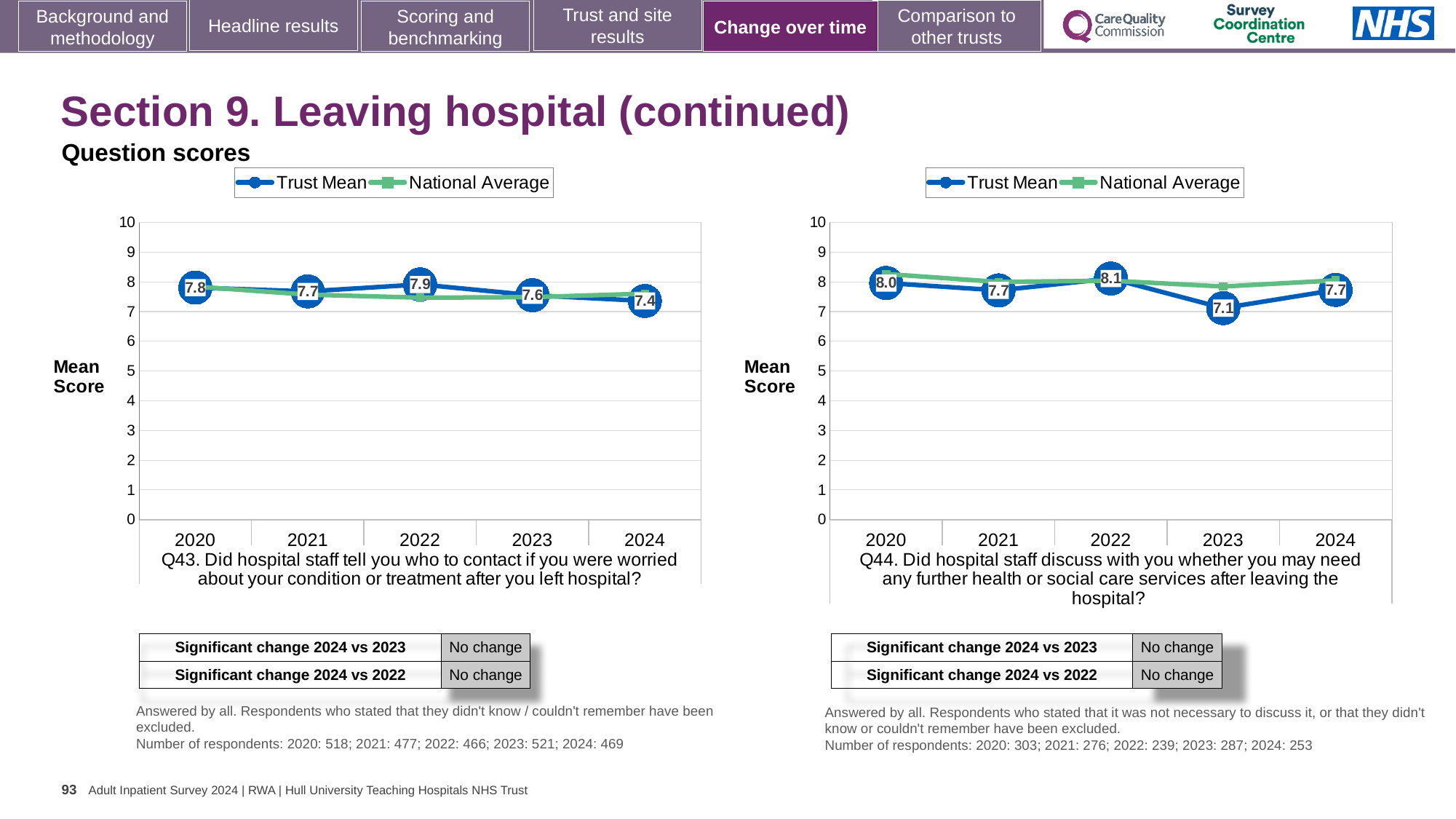
In the Q43 chart (left), what is the Trust Mean score for 2022? 7.9 What type of chart is used for Q43 (left)? Line chart In the Q44 chart (right), what is the difference between the Trust Mean scores for 2022 and 2023? 1.0 In the Q44 chart (right), which year has the highest Trust Mean score? 2022 How many series does the legend of the Q44 chart (right) list? 2 How many years are plotted on the x axis of the Q43 chart (left)? 5 In the Q44 chart (right), what is the Trust Mean score for 2020? 8.0 In the Q43 chart (left), what is the Trust Mean score for 2024? 7.4 In the Q43 chart (left), is the Trust Mean score higher in 2020 or in 2024? 2020 In the Q44 chart (right), what is the Trust Mean score for 2023? 7.1 In the Q44 chart (right), is the Trust Mean value for 2023 greater or less than 8? less In the Q43 chart (left), which year has the lowest Trust Mean score? 2024